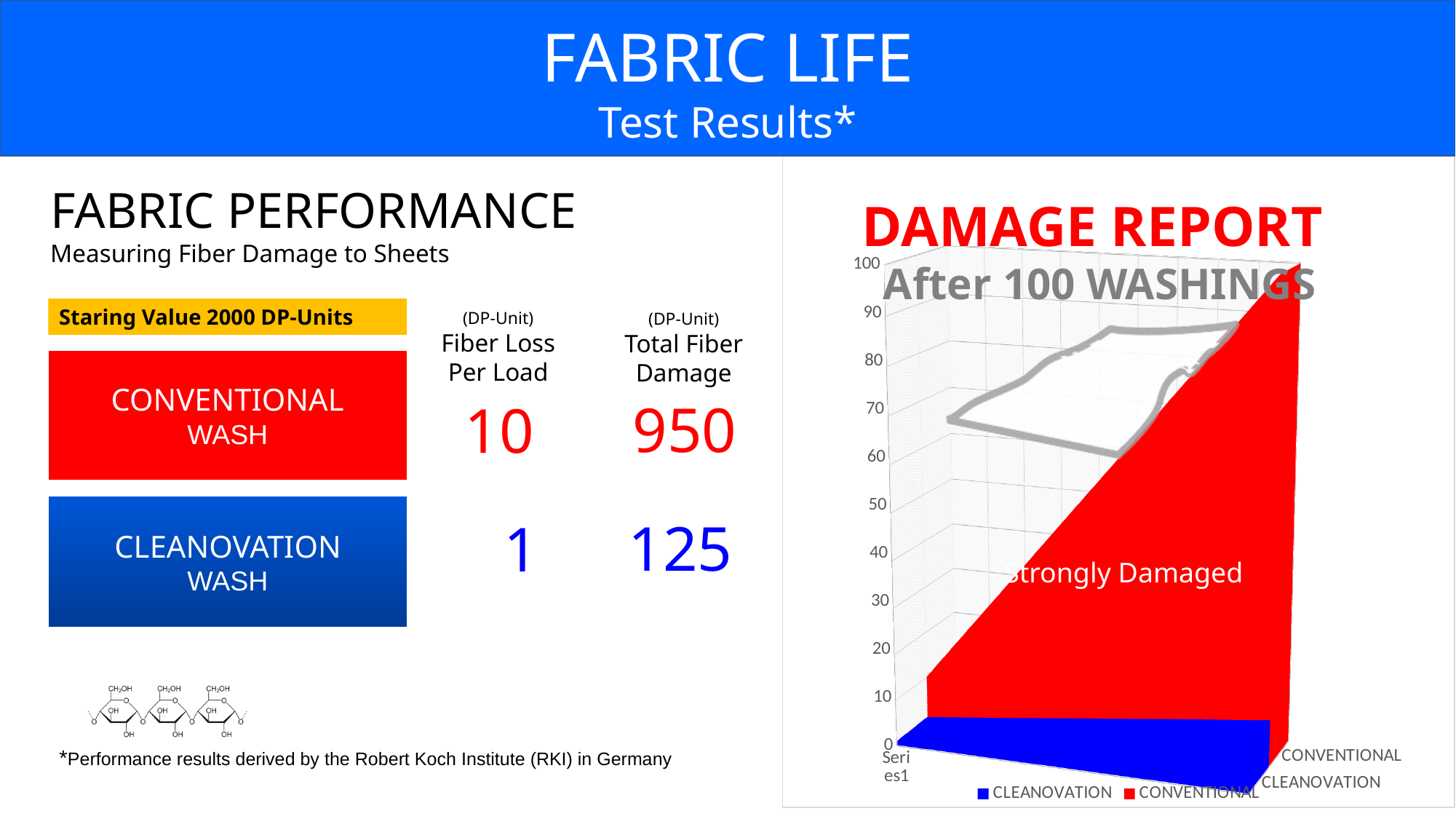
Which series in the DAMAGE REPORT chart has the lowest value? CLEANOVATION What kind of chart is the DAMAGE REPORT chart? area chart In the DAMAGE REPORT chart, is the value for CLEANOVATION greater or less than 20? less What colour represents the CONVENTIONAL series in the DAMAGE REPORT chart? red How many series does the legend of the DAMAGE REPORT chart list? 2 Which series in the DAMAGE REPORT chart has the highest value? CONVENTIONAL In the DAMAGE REPORT chart, which is larger, the value for CONVENTIONAL or the value for CLEANOVATION? CONVENTIONAL What is the highest tick value shown on the vertical axis of the DAMAGE REPORT chart? 100